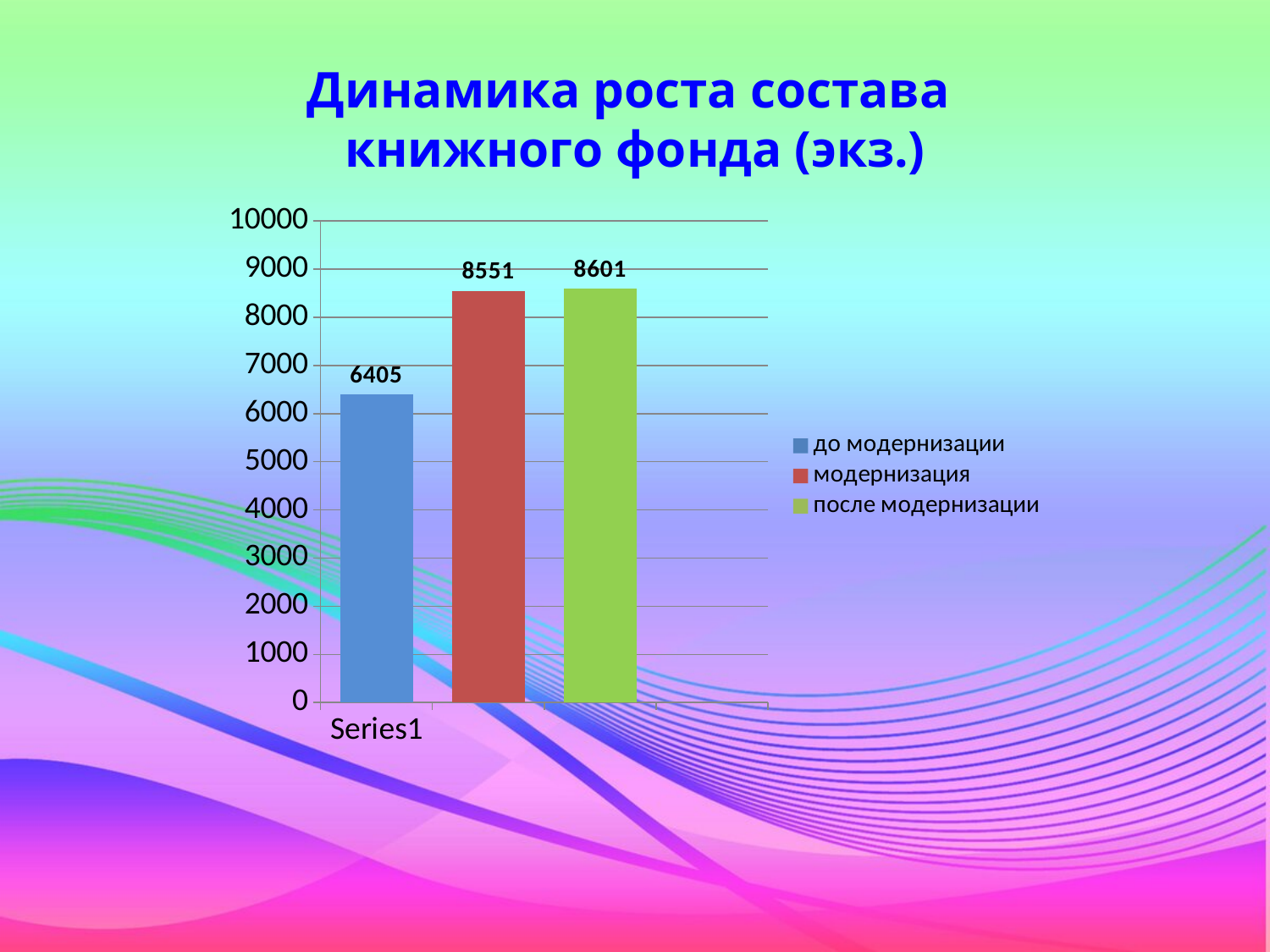
Which is larger, the value for "модернизация" or the value for "до модернизации"? модернизация Which series has the highest value? после модернизации Is the value for "до модернизации" greater or less than 7000? less How many series does the legend list? 3 What is the value for "модернизация"? 8551 What is the value for "до модернизации"? 6405 Which series has the lowest value? до модернизации What kind of chart is shown on the slide? bar chart What is the difference between the values for "модернизация" and "до модернизации"? 2146 What is the difference between the values for "после модернизации" and "до модернизации"? 2196 What is the title of the chart on the slide? Динамика роста состава книжного фонда (экз.) What is the value for "после модернизации"? 8601